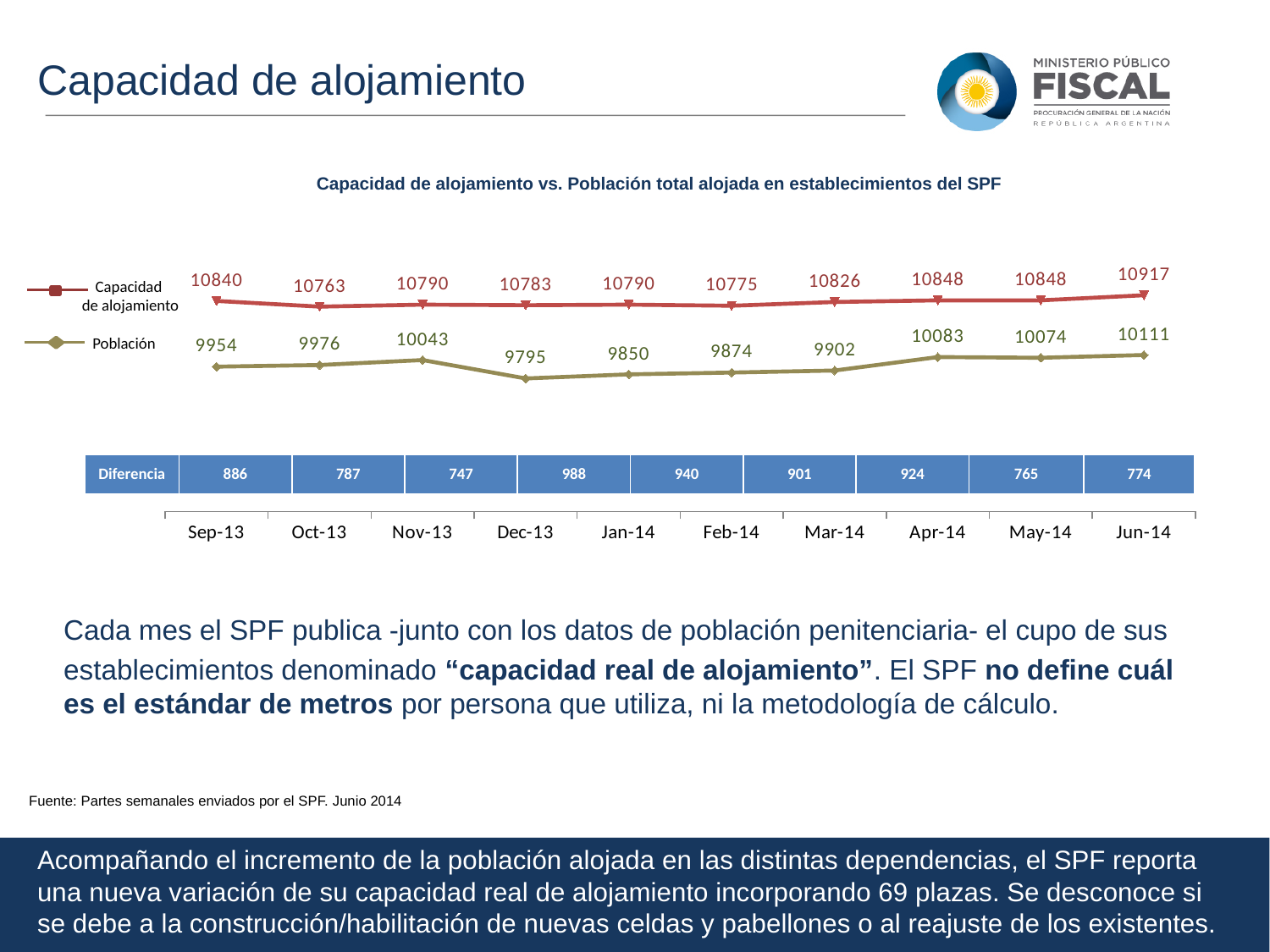
What is the difference between Capacidad de alojamiento and Población in Dec-13? 988 What is the value of Capacidad de alojamiento for Jun-14? 10917 In which month is Población lowest? Dec-13 What is the title of the chart? Capacidad de alojamiento vs. Población total alojada en establecimientos del SPF In which month is Capacidad de alojamiento highest? Jun-14 What is the value of Población for Dec-13? 9795 How many series does the legend list? 2 Which is larger in Oct-13, Capacidad de alojamiento or Población? Capacidad de alojamiento What is the value of Capacidad de alojamiento for Sep-13? 10840 How many months are plotted on the x axis? 10 What is the value of Población for Nov-13? 10043 What kind of chart is shown? Line chart